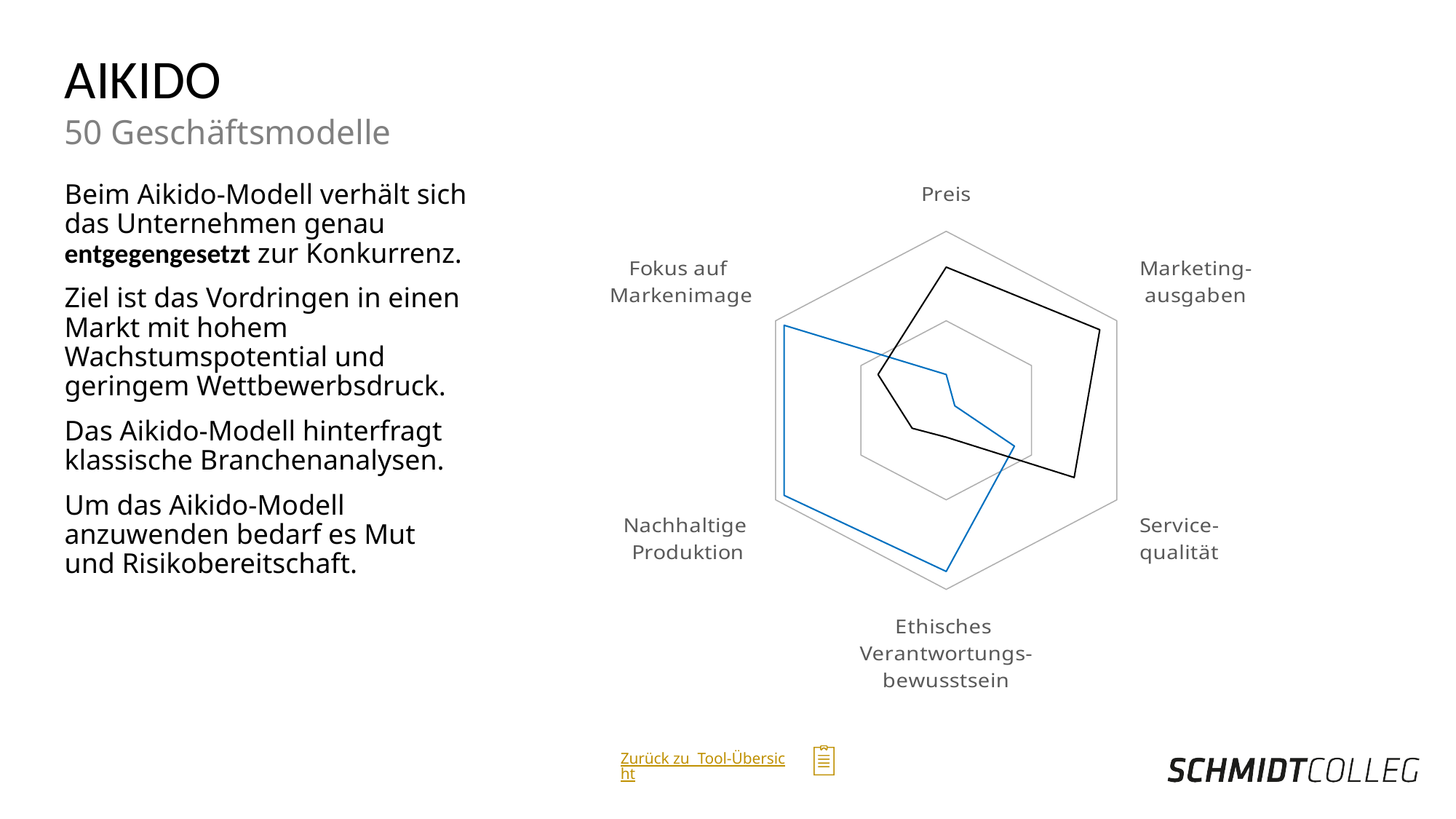
On the Servicequalität axis, which series has the larger value, the black line or the blue line? The black line On which axis does the black series reach its highest value? Marketingausgaben Which category label appears at the top of the radar chart? Preis How many categories (axes) does the radar chart have? 6 What kind of chart is shown on the slide? Radar chart On the Marketingausgaben axis, which series has the larger value, the black line or the blue line? The black line How many data series are plotted on the radar chart? 2 On the Nachhaltige Produktion axis, which series has the larger value, the black line or the blue line? The blue line On which axis does the blue series have its lowest value? Marketingausgaben